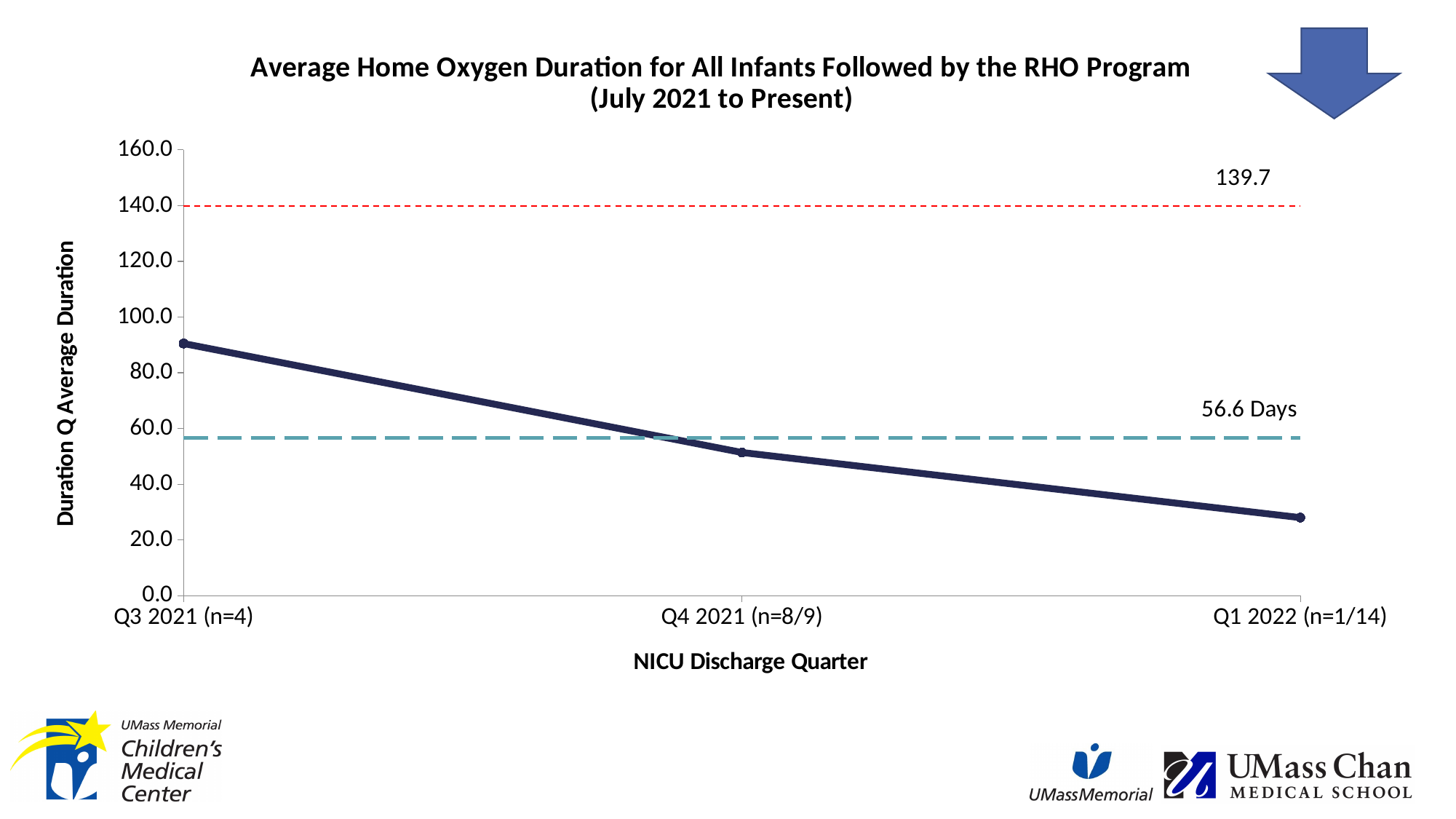
Which is larger, the value for Q4 2021 (n=8/9) or the value for Q1 2022 (n=1/14)? Q4 2021 (n=8/9) Is the value for Q3 2021 (n=4) greater or less than 80.0? greater What type of chart is shown on the slide? line chart What value is labelled on the teal dashed reference line? 56.6 Days Which quarter has the highest average duration? Q3 2021 (n=4) Is the value for Q4 2021 (n=8/9) greater or less than 60.0? less What value is labelled on the red dotted reference line? 139.7 Do the average duration values rise or fall from Q3 2021 to Q1 2022? fall Is the value for Q1 2022 (n=1/14) greater or less than 40.0? less How many NICU discharge quarters are plotted on the x axis? 3 What is the title of the chart? Average Home Oxygen Duration for All Infants Followed by the RHO Program (July 2021 to Present) Which quarter has the lowest average duration? Q1 2022 (n=1/14)